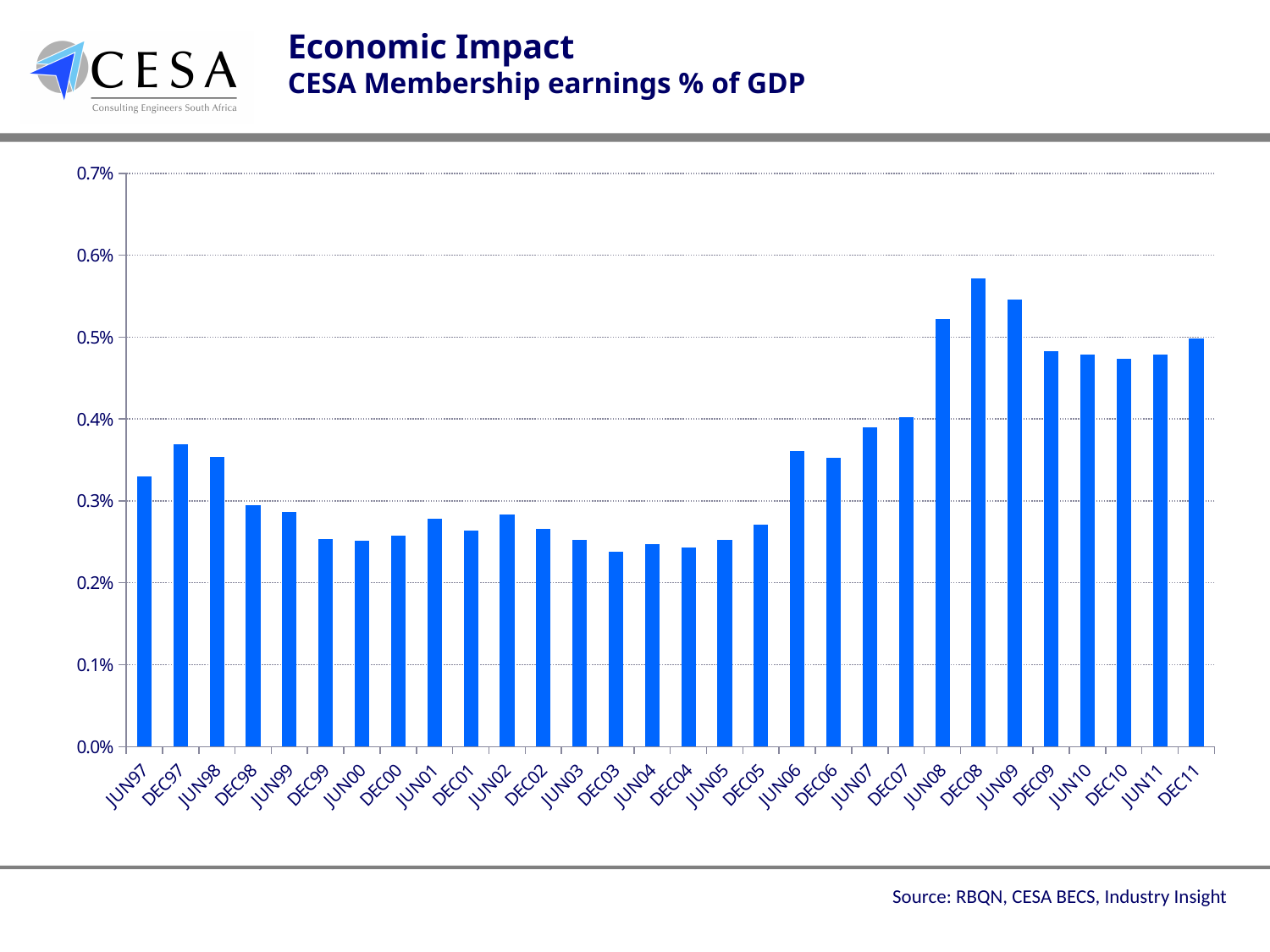
Is the value for DEC03 greater or less than 0.3%? less How many bars (periods) are plotted on the chart? 30 Is the value for DEC08 greater or less than 0.5%? greater Do the values rise or fall from JUN06 to DEC08? rise Which period has the highest CESA membership earnings as % of GDP? DEC08 Is the value for DEC09 greater or less than 0.5%? less What kind of chart is shown on the slide? bar chart What is the title of the chart on the slide? CESA Membership earnings % of GDP Which is larger, the value for DEC03 or the value for JUN06? JUN06 Which is larger, the value for JUN08 or the value for DEC08? DEC08 Which is larger, the value for JUN97 or the value for DEC97? DEC97